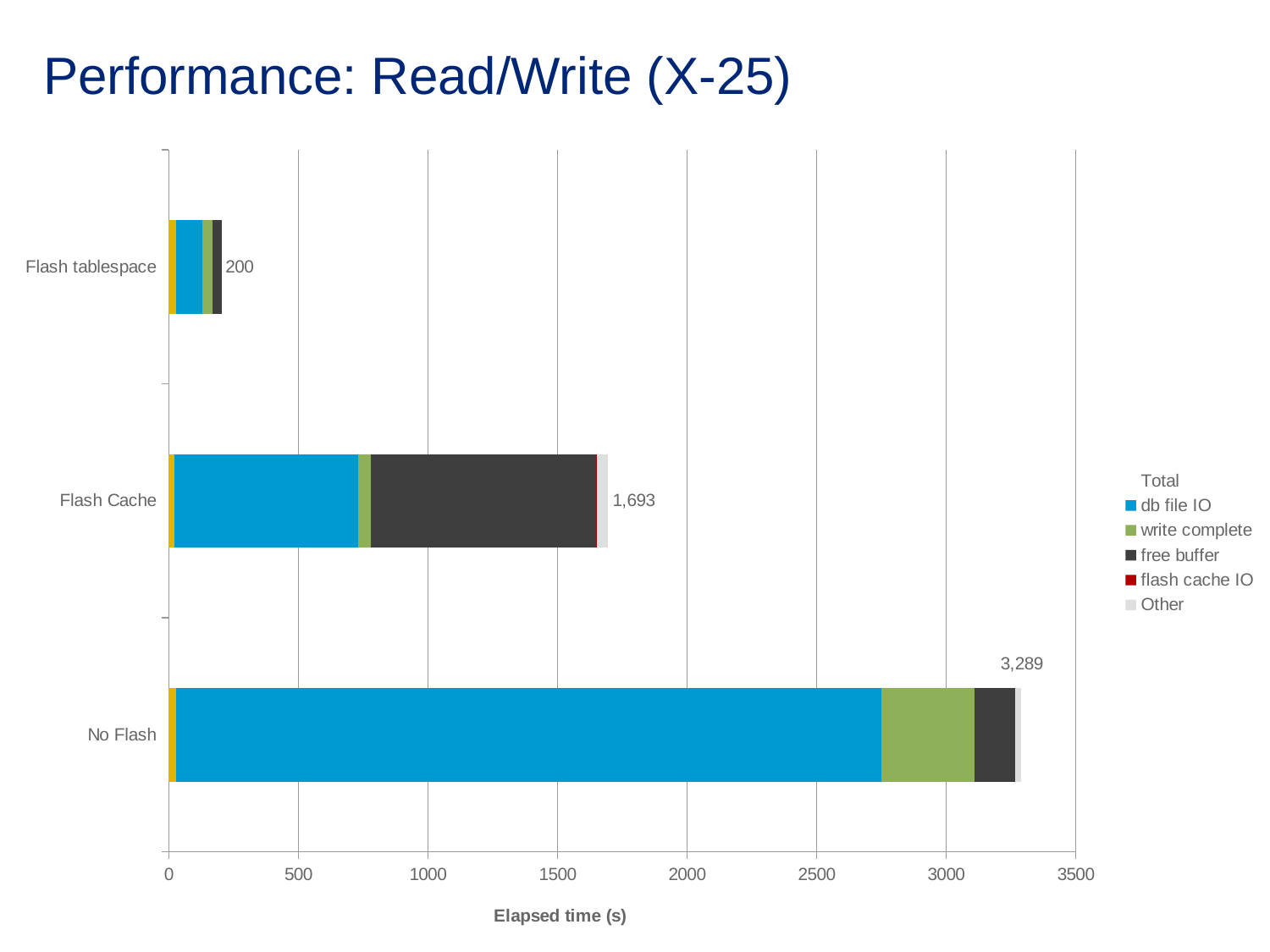
Which category has the highest total elapsed time? No Flash What is the total elapsed time labelled for the Flash Cache bar? 1,693 Which category has the lowest total elapsed time? Flash tablespace Which has a larger total elapsed time, Flash Cache or Flash tablespace? Flash Cache How many categories are shown on the vertical axis? 3 What is the label of the horizontal axis? Elapsed time (s) What is the difference between the labelled totals for No Flash and Flash Cache? 1,596 What is the total elapsed time labelled for the No Flash bar? 3,289 What kind of chart is shown on the slide? Stacked horizontal bar chart What is the total elapsed time labelled for the Flash tablespace bar? 200 Is the db file IO segment for No Flash greater or less than 2500? greater What is the difference between the labelled totals for Flash Cache and Flash tablespace? 1,493